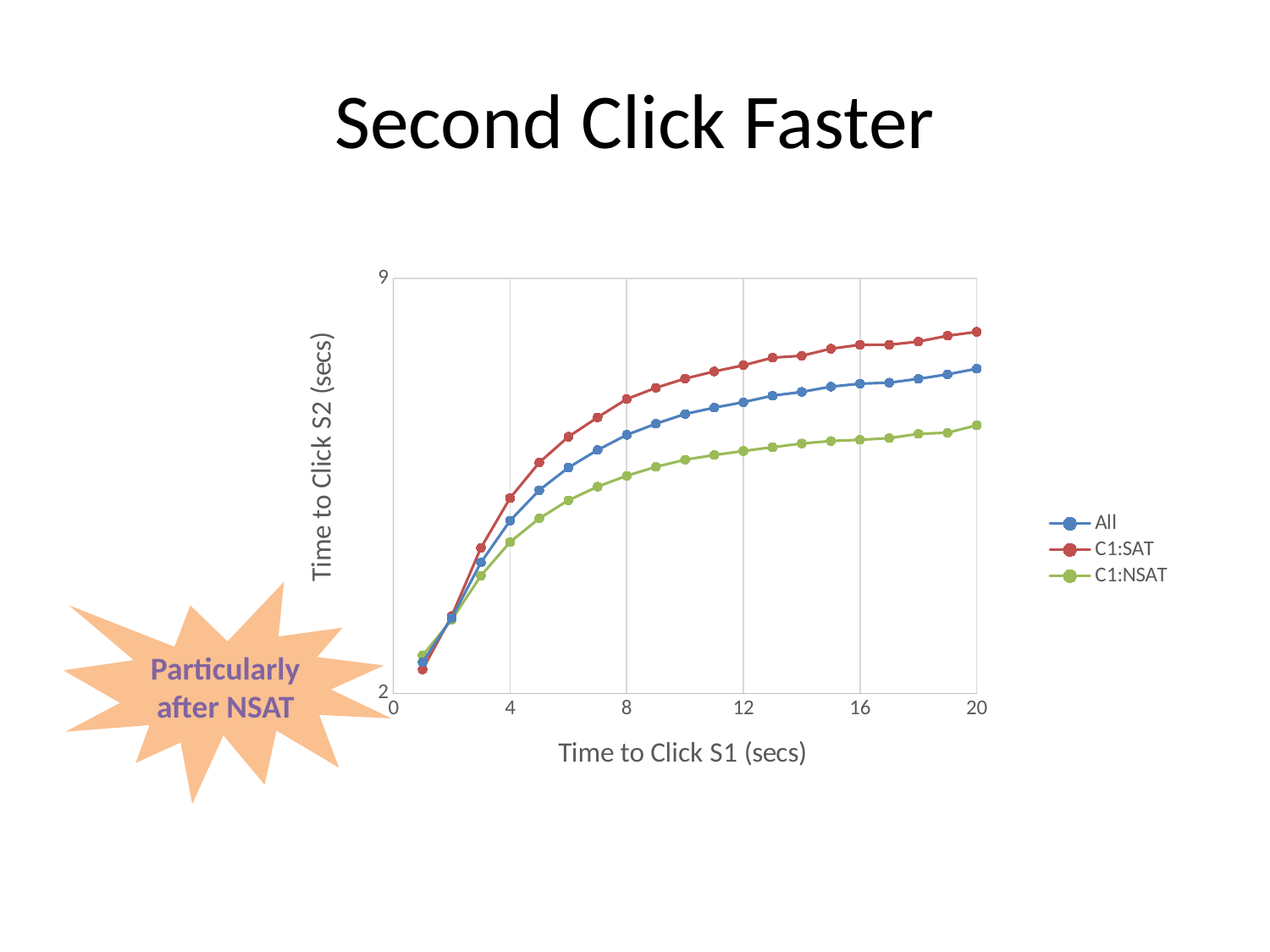
Do the values for the All series rise or fall as Time to Click S1 increases? rise What kind of chart is shown on the slide? line chart Is the Time to Click S2 value for C1:NSAT at Time to Click S1 = 10 secs greater or less than 2? greater At Time to Click S1 = 8 secs, which series has the larger Time to Click S2, All or C1:NSAT? All At Time to Click S1 = 12 secs, which series has the larger Time to Click S2, C1:SAT or C1:NSAT? C1:SAT Is the Time to Click S2 value for C1:SAT at Time to Click S1 = 20 secs greater or less than 9? less Which series has the lowest Time to Click S2 at Time to Click S1 = 20 secs? C1:NSAT Which series has the highest Time to Click S2 at Time to Click S1 = 20 secs? C1:SAT How many series does the legend list? 3 How many data points are plotted for the C1:SAT series? 20 What is the title of the x axis of the chart? Time to Click S1 (secs) Which series is drawn in green in the chart? C1:NSAT